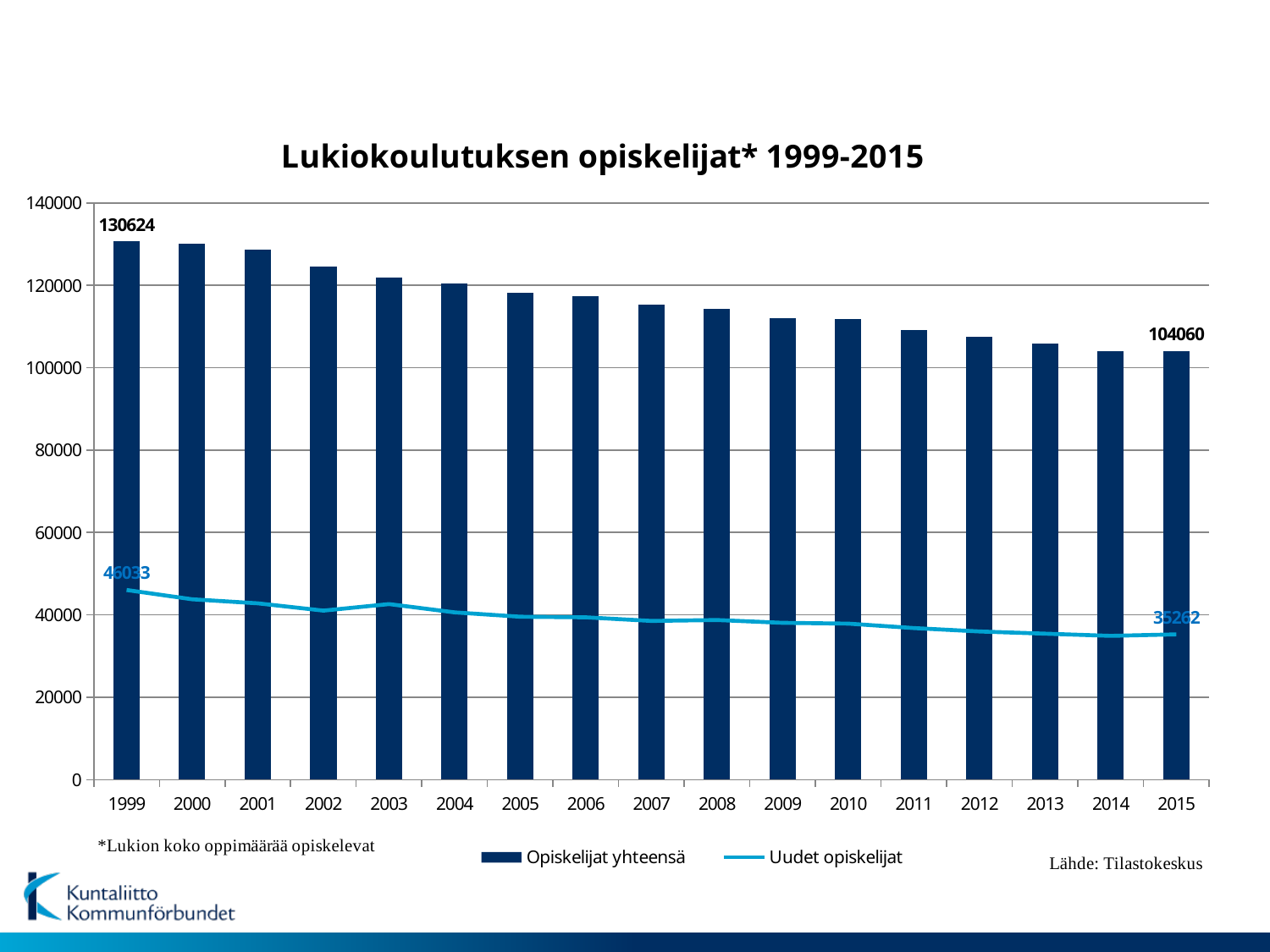
Which year has the highest value for Opiskelijat yhteensä? 1999 What is the value of Uudet opiskelijat for 1999? 46033 How many series does the legend list? 2 What is the value of Opiskelijat yhteensä for 1999? 130624 Which year has the lowest value for Opiskelijat yhteensä? 2014 What is the value of Uudet opiskelijat for 2015? 35262 Is the value of Opiskelijat yhteensä for 2008 greater or less than 120000? less By how much did Opiskelijat yhteensä decrease from 1999 to 2015? 26564 How many years are shown on the x axis? 17 Is the value of Opiskelijat yhteensä for 2003 greater or less than 120000? greater What is the difference between Uudet opiskelijat in 1999 and in 2015? 10771 What is the value of Opiskelijat yhteensä for 2015? 104060